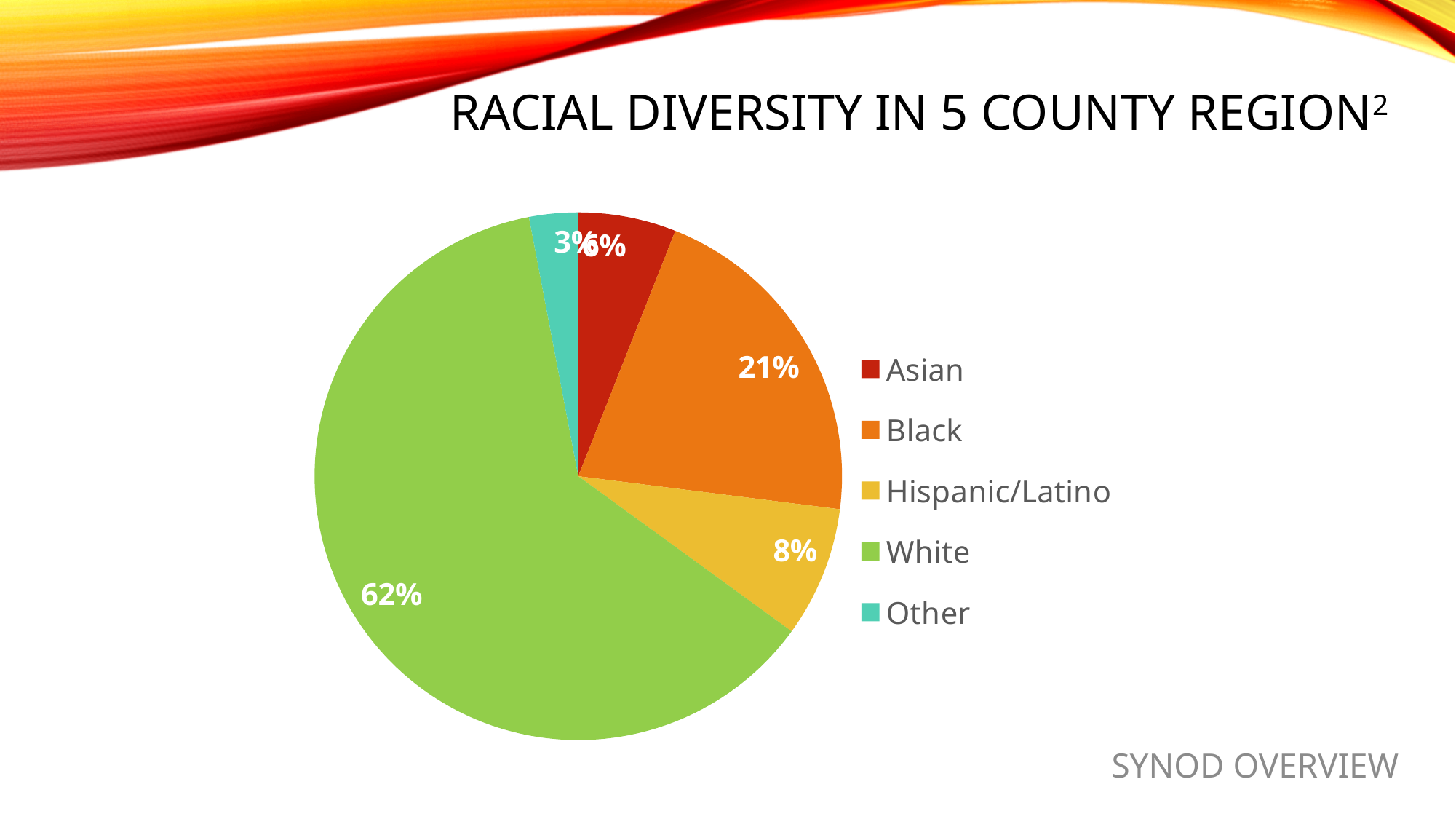
Which category has the smallest slice of the pie? Other What share of the pie does White represent? 62% What share of the pie does Hispanic/Latino represent? 8% How many categories does the pie chart show? 5 Which slice is larger, Black or Hispanic/Latino? Black Which category has the largest slice of the pie? White What kind of chart is shown on the slide? pie chart What share of the pie does Black represent? 21% What share of the pie does Other represent? 3% What is the title of the chart on the slide? Racial Diversity in 5 County Region What share of the pie does Asian represent? 6% What is the difference in percentage points between the White and Black slices? 41